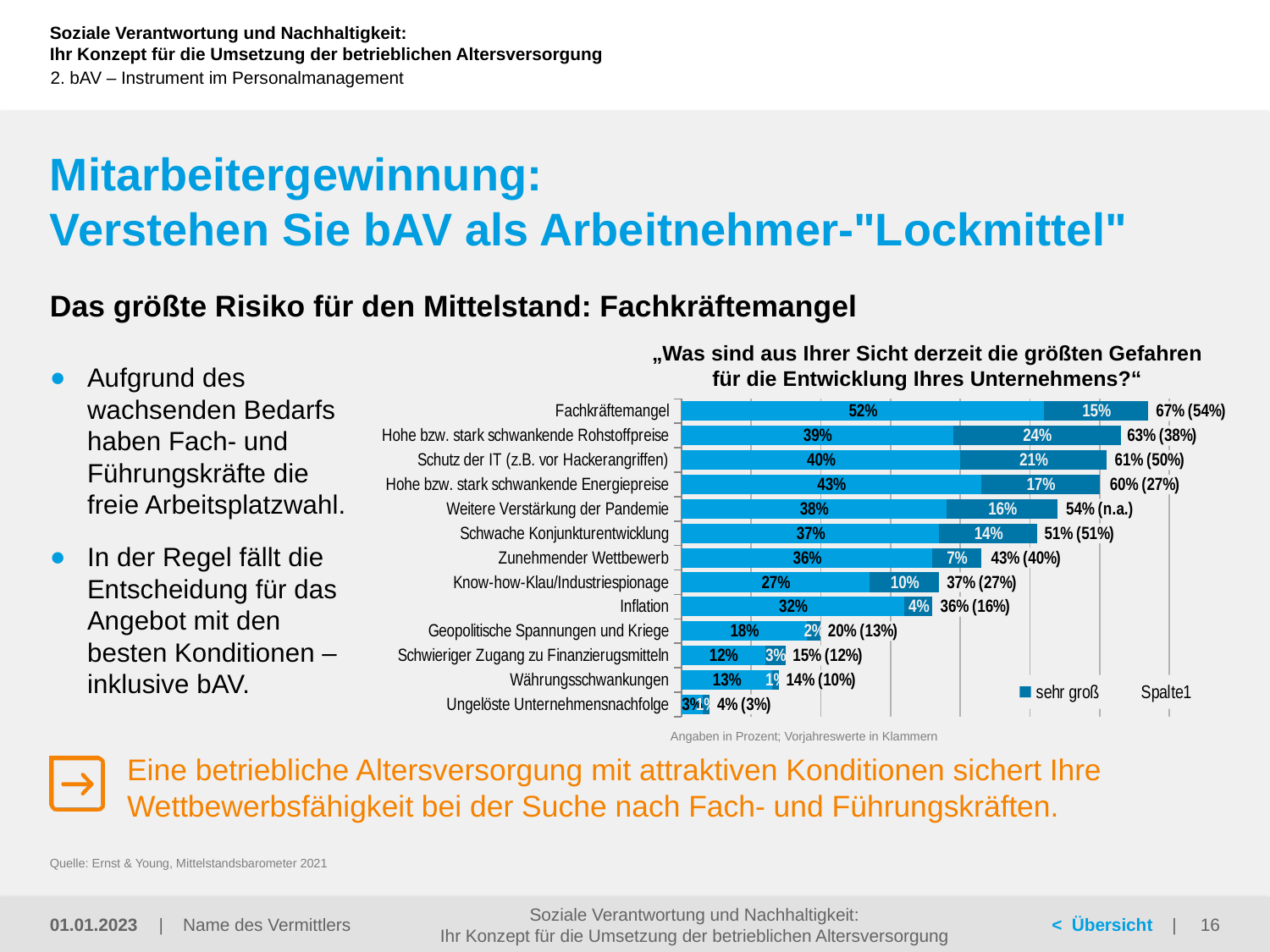
What is the total value shown for Fachkräftemangel? 67% (54%) What is the value of the first (light blue) segment for Hohe bzw. stark schwankende Energiepreise? 43% What is the total value shown for Inflation? 36% (16%) What kind of chart is shown on the slide? bar chart Which category has the lowest total value? Ungelöste Unternehmensnachfolge Which has a larger total value, Zunehmender Wettbewerb or Know-how-Klau/Industriespionage? Zunehmender Wettbewerb What question is given as the title of the chart? „Was sind aus Ihrer Sicht derzeit die größten Gefahren für die Entwicklung Ihres Unternehmens?“ What is the 'sehr groß' (dark blue) value for Hohe bzw. stark schwankende Rohstoffpreise? 24% How many categories (risks) are listed in the chart? 13 Which category has the highest total value? Fachkräftemangel What is the sum of the two segments (38% and 16%) for Weitere Verstärkung der Pandemie? 54% What is the difference between the total for Fachkräftemangel (67%) and the total for Schutz der IT (61%)? 6%